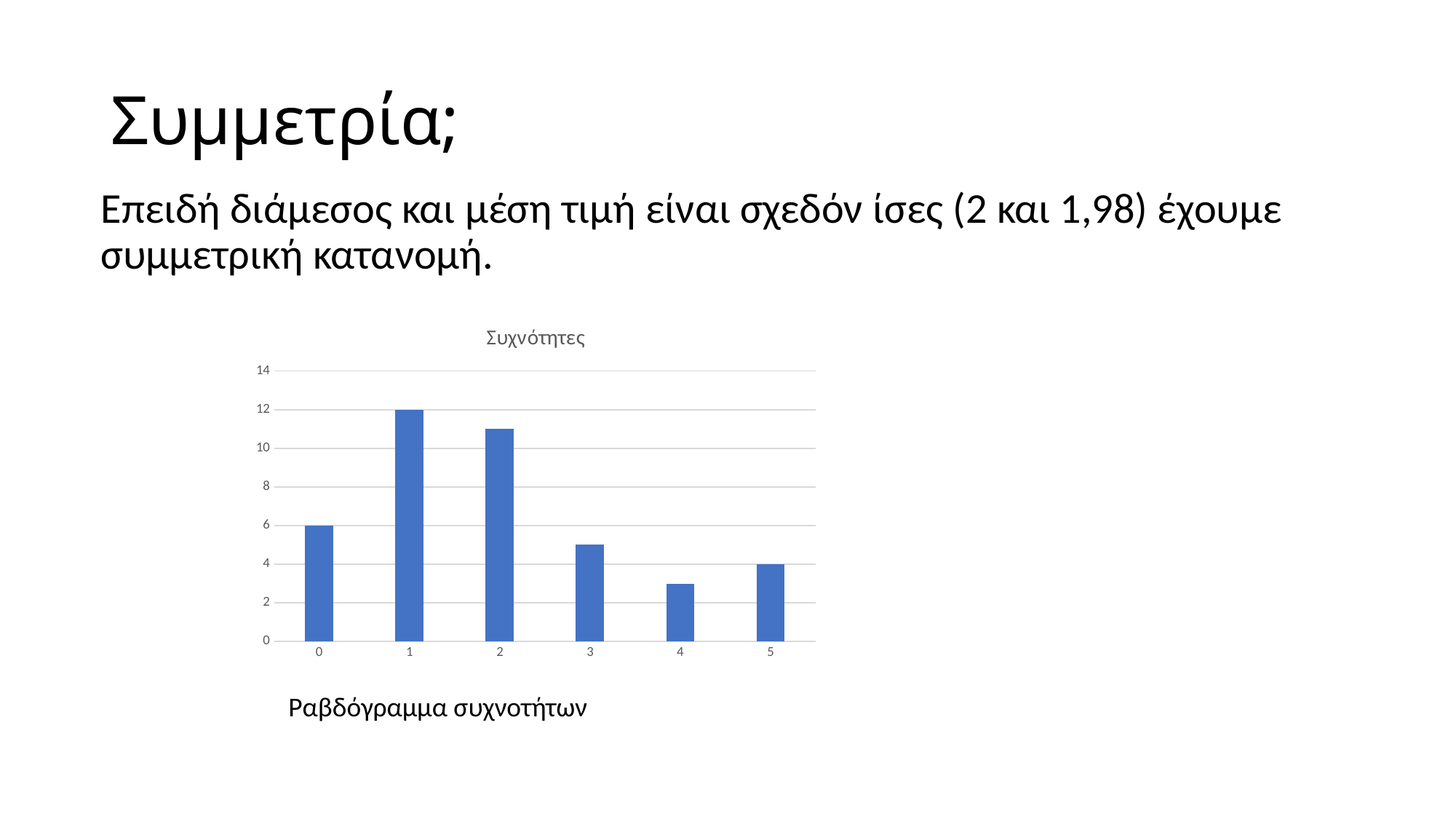
Which category has the lowest bar? 4 What is the value of the bar for category 1? 12 Which category has the highest bar? 1 Which has a larger value, category 2 or category 3? 2 Is the value for category 2 greater or less than 10? greater What kind of chart is shown on the slide? bar chart What is the title of the chart? Συχνότητες What is the value of the bar for category 0? 6 What is the value of the bar for category 5? 4 What is the difference between the values for category 1 and category 0? 6 Is the value for category 4 greater or less than 4? less How many categories are shown on the x axis? 6